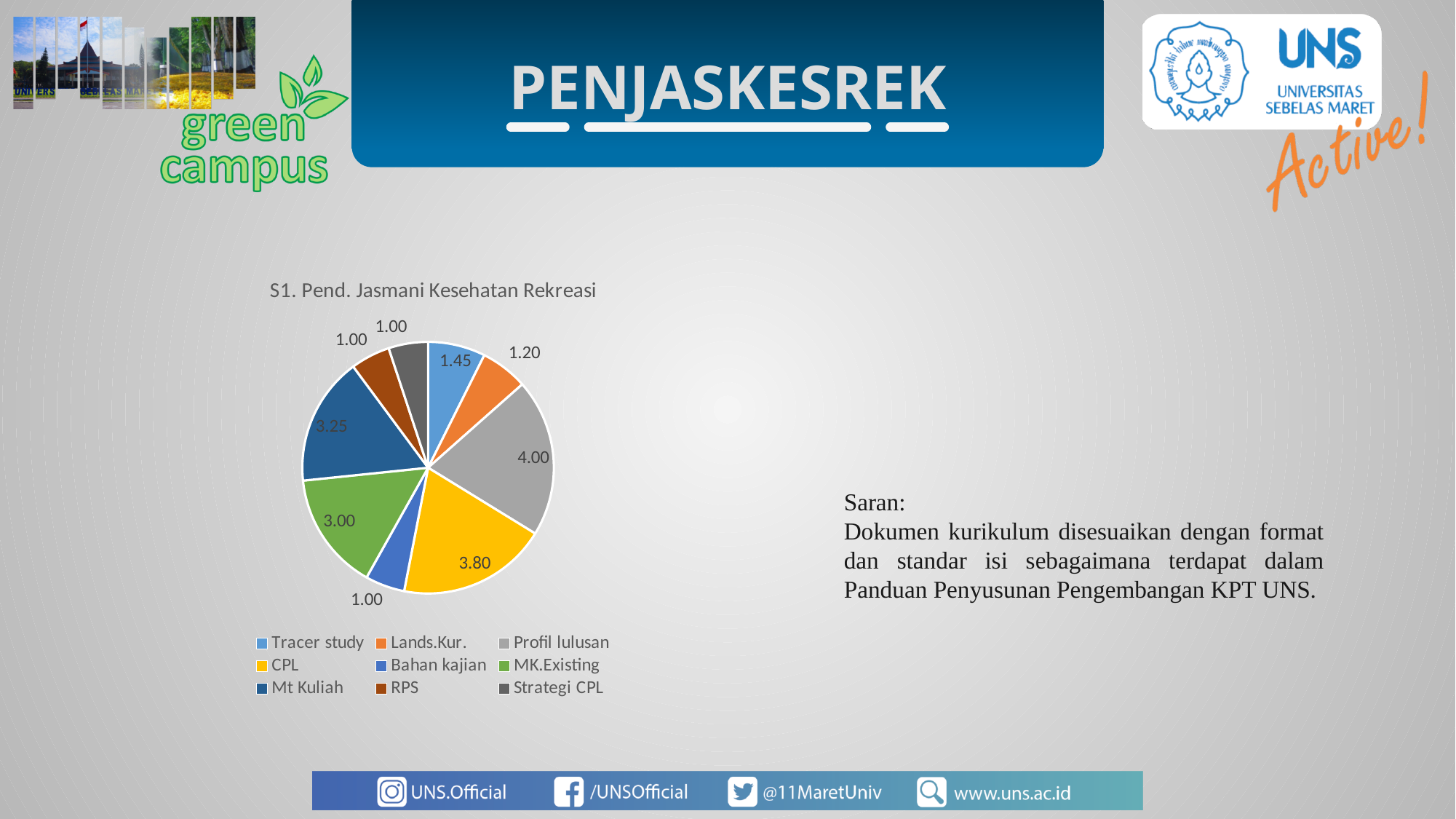
What is the value for Tracer study in the pie chart? 1.45 How many categories does the legend of the pie chart list? 9 What is the title of the pie chart? S1. Pend. Jasmani Kesehatan Rekreasi What is the value for Mt Kuliah in the pie chart? 3.25 Which is larger, the value for MK.Existing or the value for Mt Kuliah? Mt Kuliah What is the difference between the values for Profil lulusan and CPL? 0.20 What is the value for Profil lulusan in the pie chart? 4.00 What is the difference between the values for CPL and Bahan kajian? 2.80 What is the value for Lands.Kur. in the pie chart? 1.20 What colour is the slice for CPL in the pie chart? Yellow Which category has the largest slice in the pie chart? Profil lulusan What kind of chart is shown on the slide? Pie chart